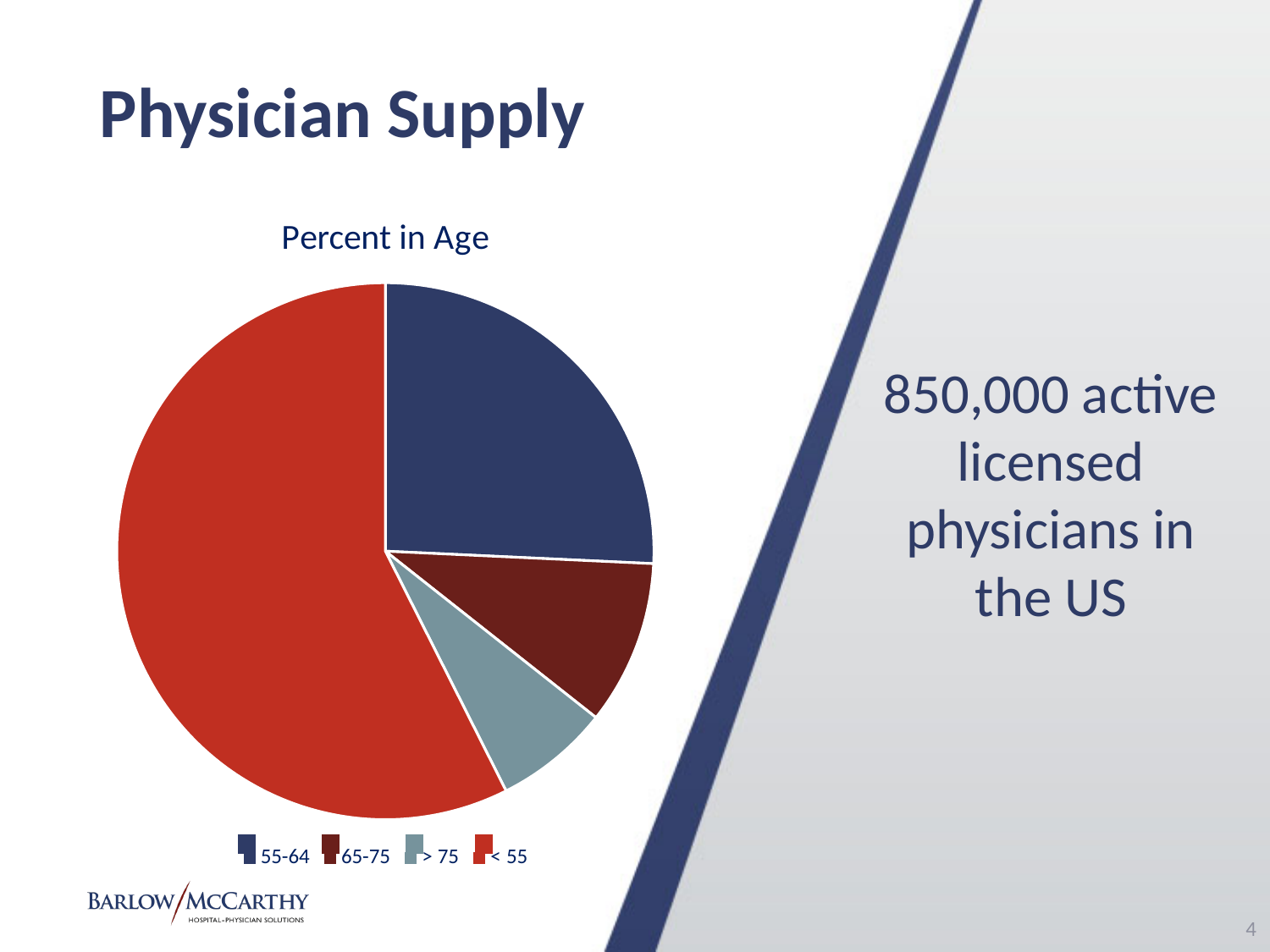
What kind of chart is shown on the slide? Pie chart Which slice is larger, 55-64 or 65-75? 55-64 Which slice is larger, < 55 or 55-64? < 55 Which slice is larger, 65-75 or > 75? 65-75 How many slices does the pie chart have? 4 Which age group is shown in dark blue in the pie chart? 55-64 What is the title of the pie chart? Percent in Age Which age group has the smallest slice of the pie chart? > 75 How many entries does the legend of the pie chart list? 4 Which age group has the largest slice of the pie chart? < 55